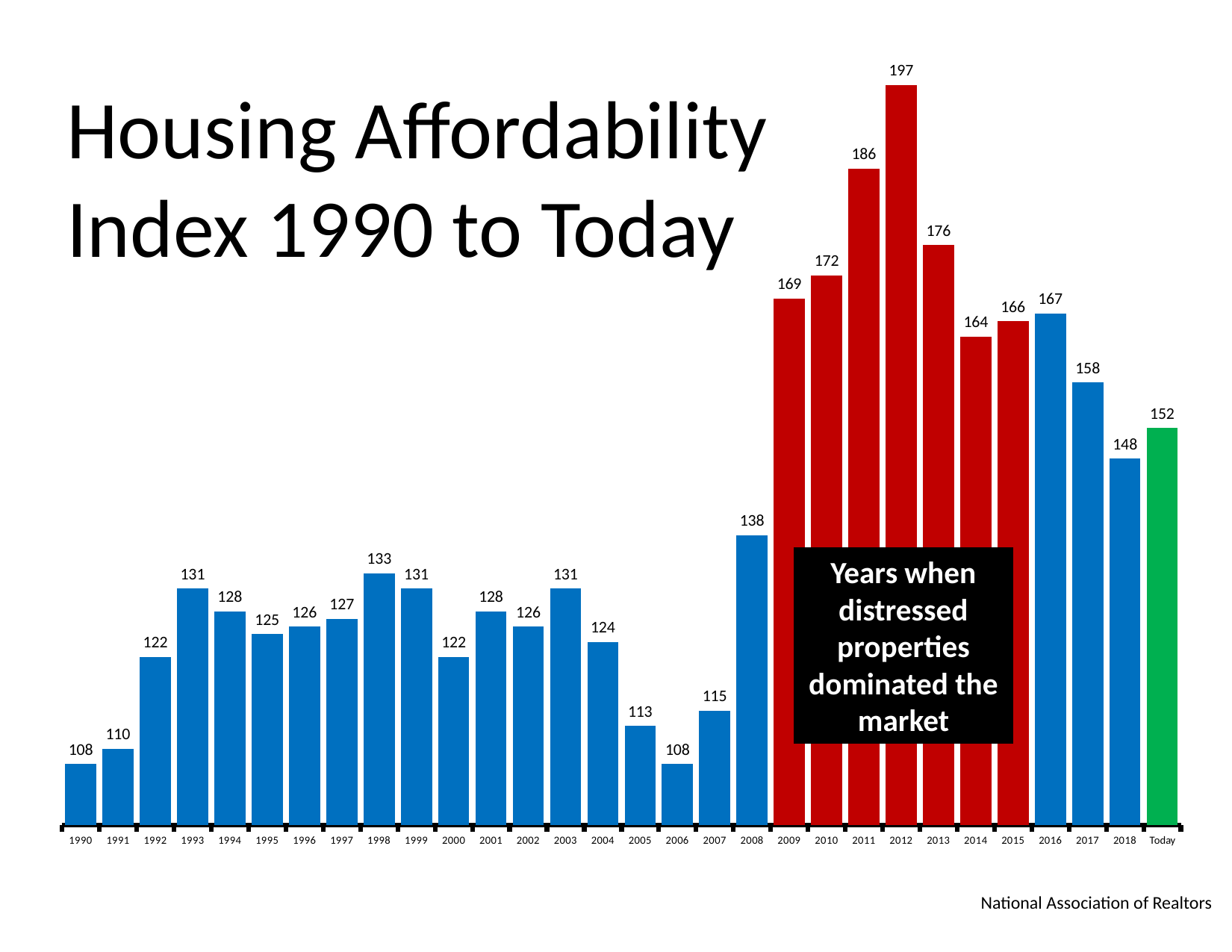
What do the red bars on the chart represent? Years when distressed properties dominated the market Which year has a higher Housing Affordability Index, 2017 or 2018? 2017 What is the Housing Affordability Index value for 2008? 138 What kind of chart is shown on the slide? Bar chart What is the lowest Housing Affordability Index value shown on the chart? 108 Does the Housing Affordability Index rise or fall from 2012 to 2018? Fall What is the Housing Affordability Index value for 2012? 197 What is the difference between the Housing Affordability Index in 2009 and 2008? 31 What is the difference between the Housing Affordability Index in 2012 and Today? 45 How many bars are plotted on the chart? 30 Which year has the highest Housing Affordability Index value? 2012 What is the Housing Affordability Index value for Today? 152